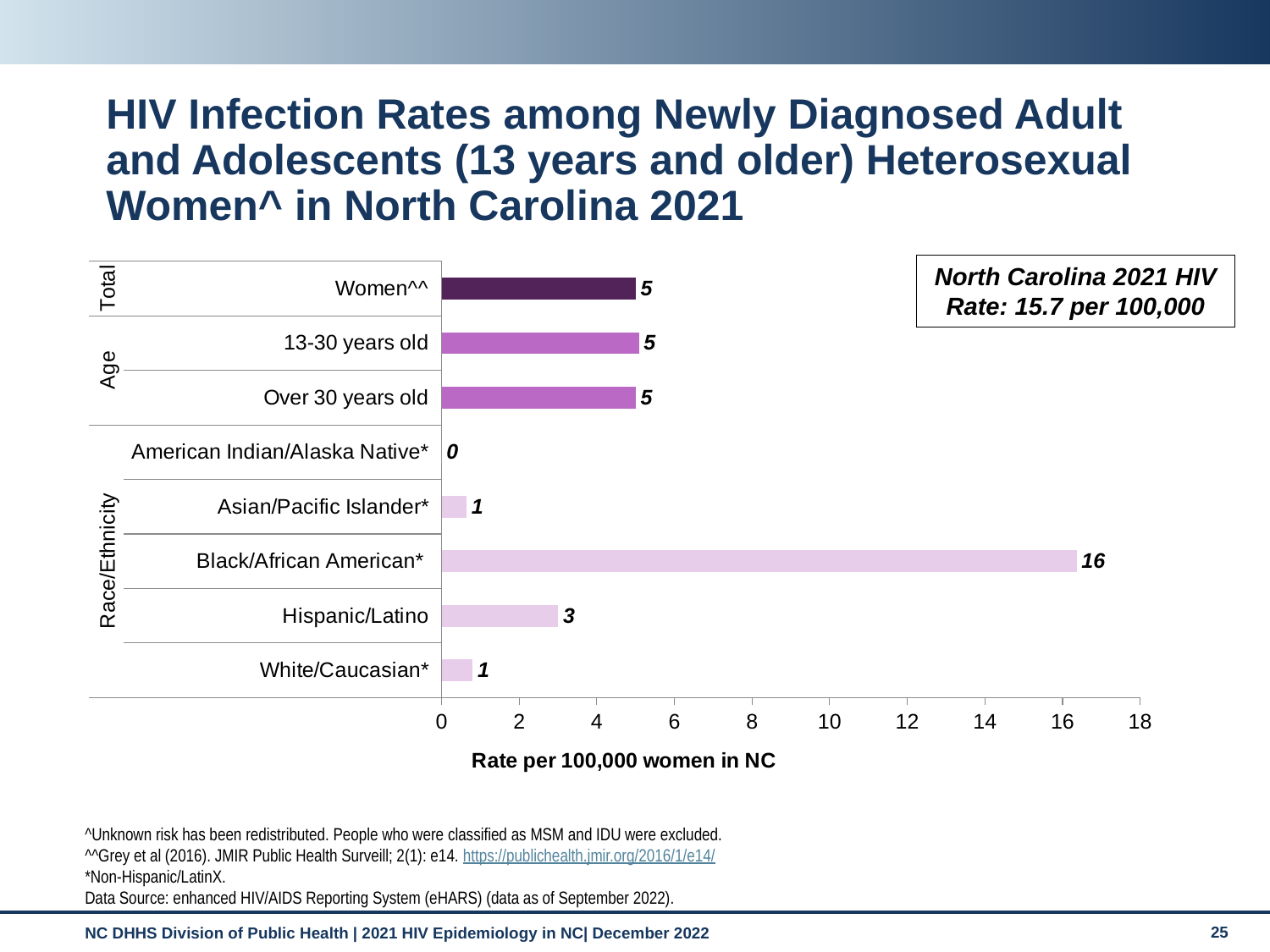
What is the rate per 100,000 for Black/African American* women? 16 What is the rate per 100,000 for American Indian/Alaska Native* women? 0 What is the label of the x axis? Rate per 100,000 women in NC What is the rate per 100,000 for women 13-30 years old? 5 What is the North Carolina 2021 HIV rate stated in the box on the slide? 15.7 per 100,000 Which race/ethnicity category has the highest rate? Black/African American* What is the difference between the rate for Black/African American* women and the rate for Hispanic/Latino women? 13 What is the rate per 100,000 for Hispanic/Latino women? 3 Which is larger, the rate for Hispanic/Latino women or the rate for White/Caucasian* women? Hispanic/Latino What kind of chart is shown on the slide? Bar chart Which category has the lowest rate on the chart? American Indian/Alaska Native* How many categories are plotted on the chart? 8